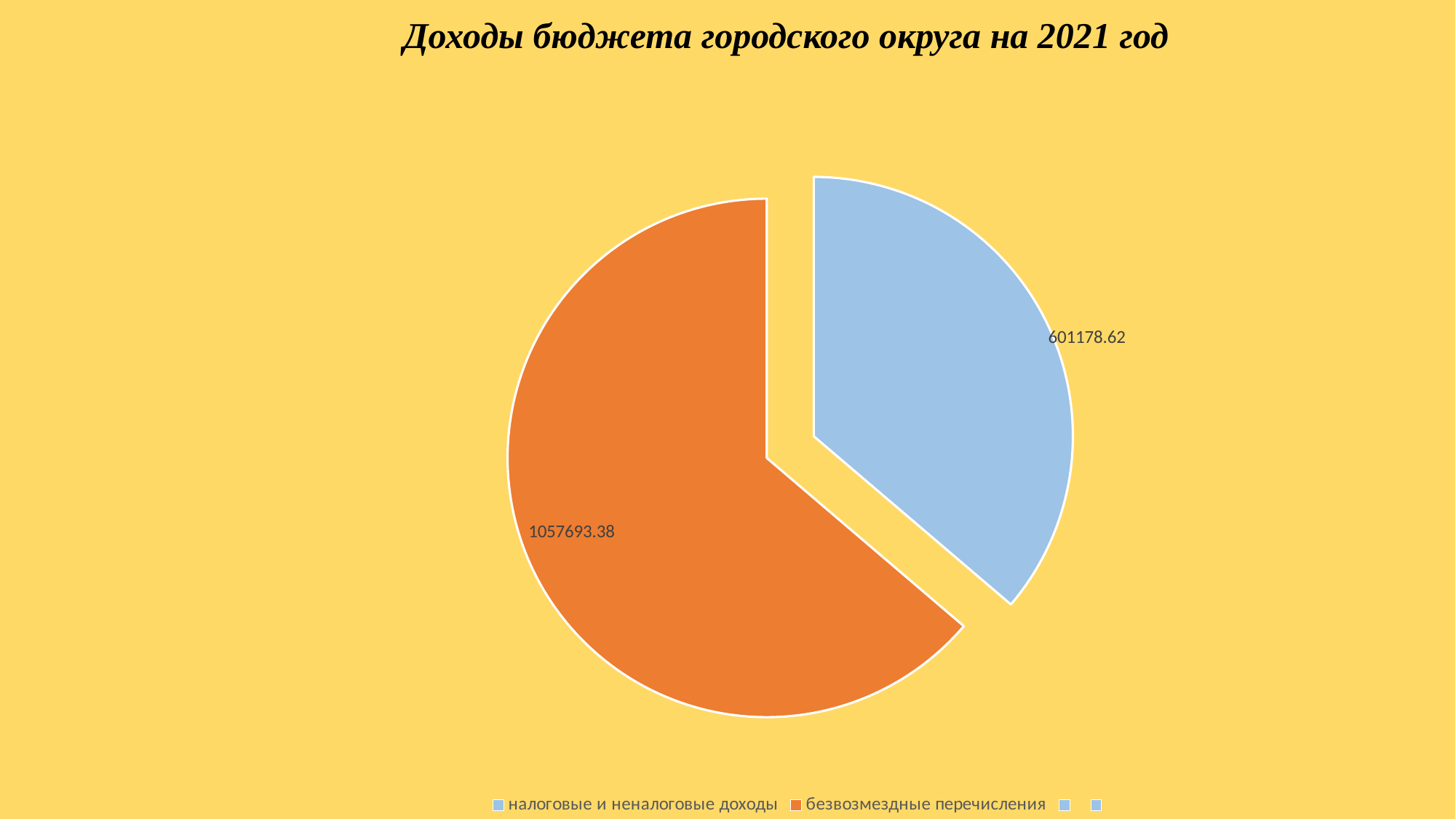
What is the value for безвозмездные перечисления? 1057693.38 What colour is the slice for безвозмездные перечисления? orange What is the difference between безвозмездные перечисления and налоговые и неналоговые доходы? 456514.76 What share of the pie does налоговые и неналоговые доходы represent? 36.2% How many slices with data labels does the pie chart have? 2 What is the title of the chart? Доходы бюджета городского округа на 2021 год What kind of chart is shown on the slide? pie chart What is the value for налоговые и неналоговые доходы? 601178.62 What is the total of the two slices shown in the pie? 1658872.00 Which category has the smallest slice of the pie? налоговые и неналоговые доходы Which category has the largest slice of the pie? безвозмездные перечисления Which is larger: налоговые и неналоговые доходы or безвозмездные перечисления? безвозмездные перечисления